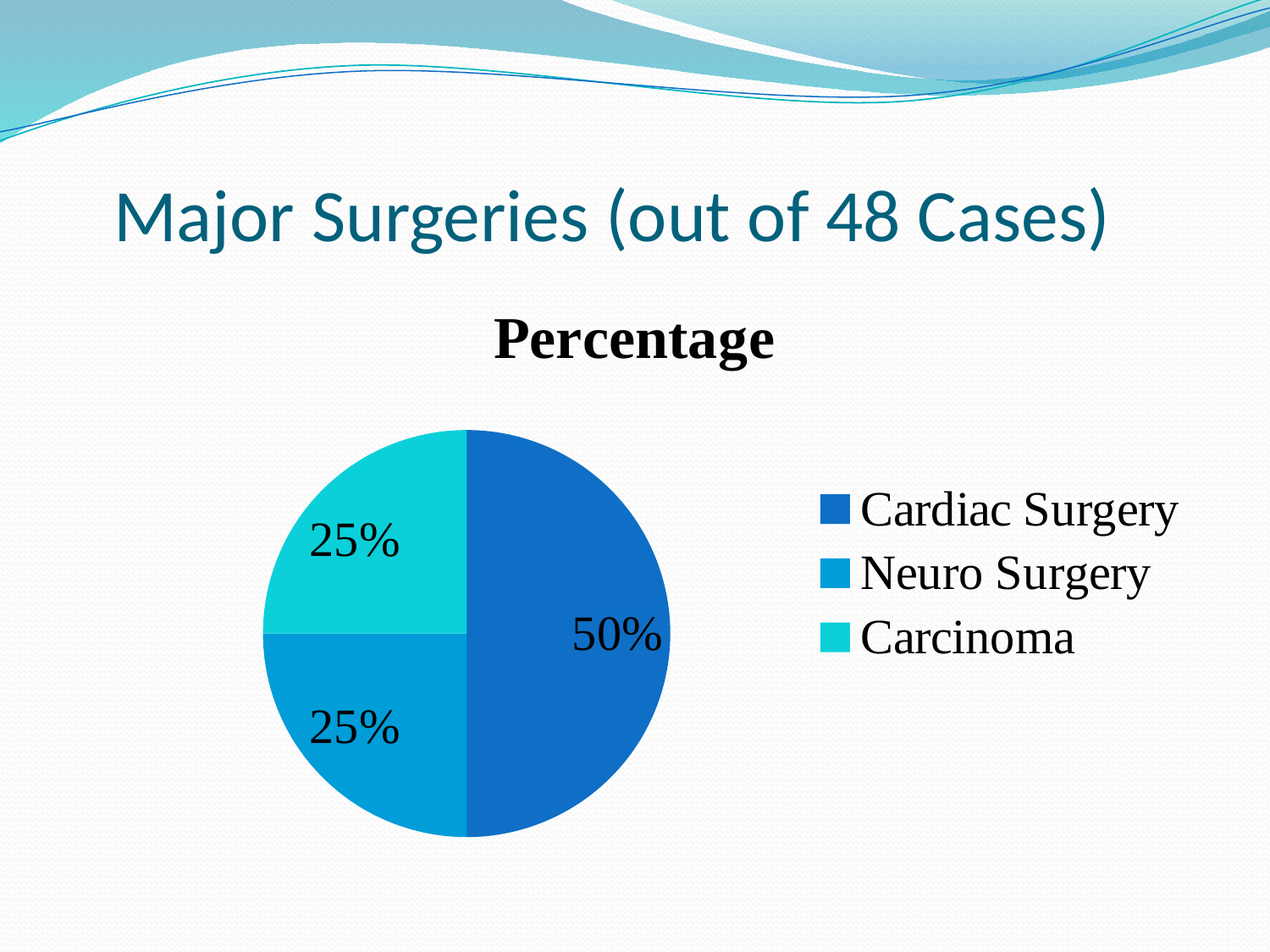
What percentage of the pie is Neuro Surgery? 25% What percentage of the pie is Carcinoma? 25% What kind of chart is shown on the slide? pie chart Which is larger, the share for Cardiac Surgery or the share for Carcinoma? Cardiac Surgery Which legend entry is shown in the lightest shade of blue? Carcinoma What is the combined share of Neuro Surgery and Carcinoma? 50% What is the chart's title? Percentage What percentage of the pie is Cardiac Surgery? 50% Which category has the largest share of the pie? Cardiac Surgery How many categories does the legend list? 3 What is the difference between the Cardiac Surgery share and the Neuro Surgery share? 25%